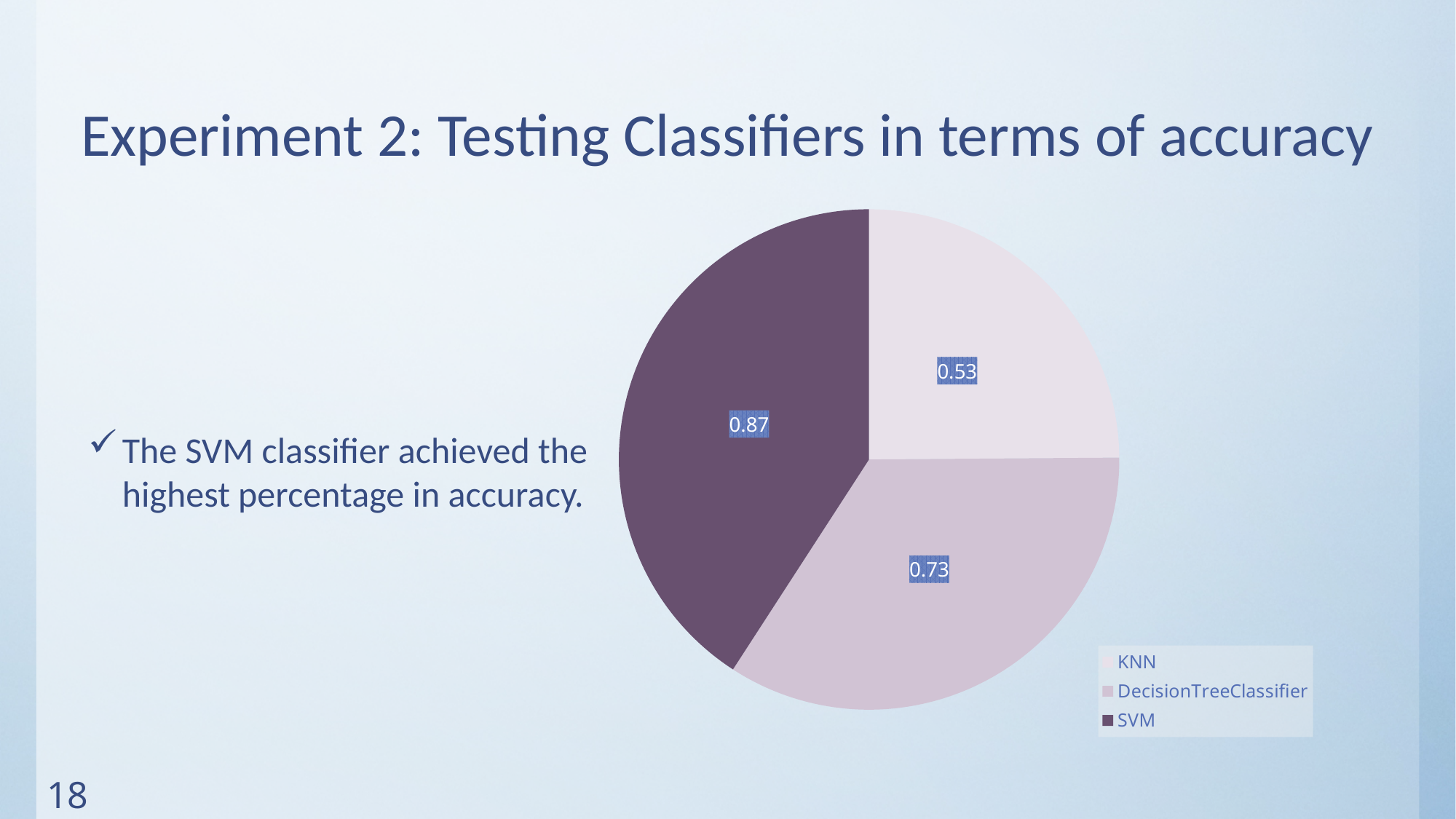
What is the difference between the SVM value and the KNN value in the pie chart? 0.34 What is the value shown for the KNN slice of the pie chart? 0.53 What is the difference between the SVM value and the DecisionTreeClassifier value in the pie chart? 0.14 What is the value shown for the SVM slice of the pie chart? 0.87 Which classifier has the highest value in the pie chart? SVM How many slices does the pie chart have? 3 What is the difference between the DecisionTreeClassifier value and the KNN value in the pie chart? 0.20 Which classifier has the lowest value in the pie chart? KNN What kind of chart is shown on the slide? Pie chart Which classifier is represented by the darkest slice in the pie chart? SVM Which has a larger value in the pie chart, KNN or DecisionTreeClassifier? DecisionTreeClassifier What is the value shown for the DecisionTreeClassifier slice of the pie chart? 0.73